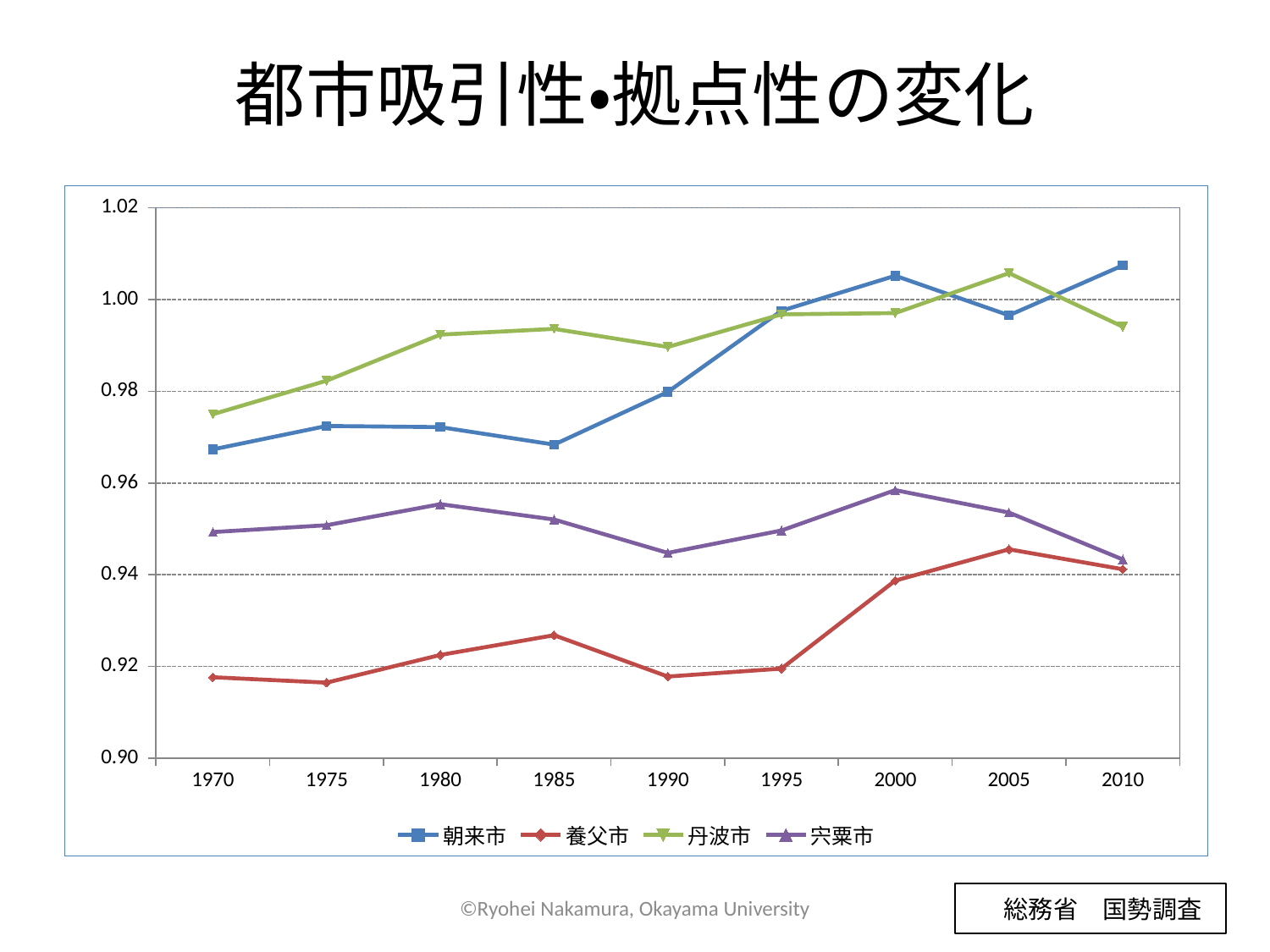
In 2010, which is larger: the value for 朝来市 or the value for 丹波市? 朝来市 In 1970, which is larger: the value for 宍粟市 or the value for 養父市? 宍粟市 Is the value for 養父市 in 1970 greater or less than 0.92? less Is the value for 宍粟市 in 1990 greater or less than 0.95? less Is the value for 朝来市 in 2010 greater or less than 1.00? greater Does the value for 養父市 rise or fall from 1990 to 2005? rise Which series has the highest value in 1985? 丹波市 What kind of chart is shown on the slide? line chart How many years are plotted along the x axis? 9 Which series has the lowest value in 1990? 養父市 How many series does the legend list? 4